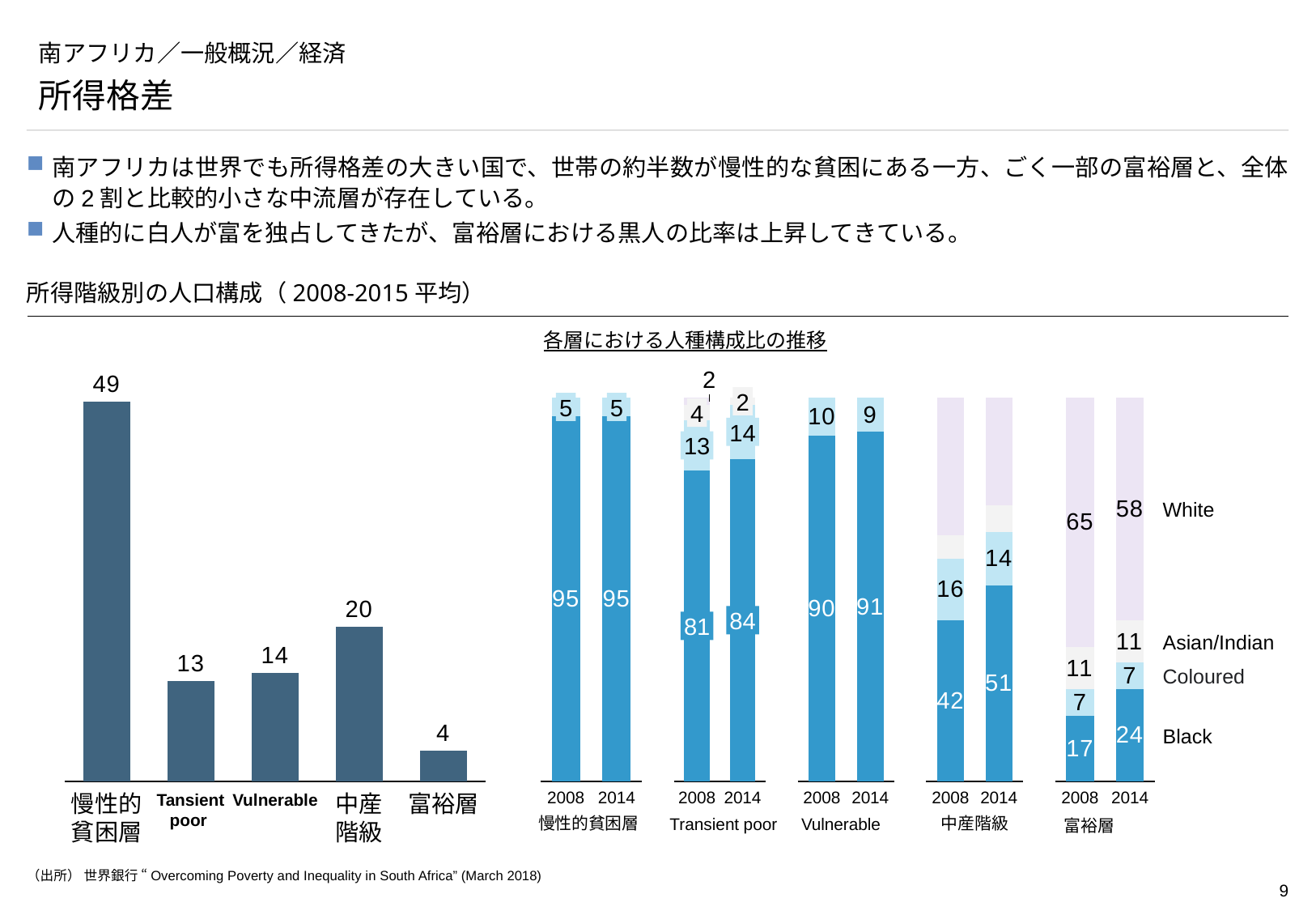
In the right chart (各層における人種構成比の推移), what is the White share of the 富裕層 in 2008? 65 In the right chart (各層における人種構成比の推移), is the Black share of Vulnerable larger in 2008 or 2014? 2014 In the right chart (各層における人種構成比の推移), what is the Black share of the 中産階級 in 2014? 51 In the right chart (各層における人種構成比の推移), what is the Black share of the 富裕層 in 2014? 24 In the left chart (所得階級別の人口構成), which category has the highest value? 慢性的貧困層 In the left chart (所得階級別の人口構成), what is the difference between the values for Vulnerable and Tansient poor? 1 In the left chart (所得階級別の人口構成), which category has the lowest value? 富裕層 What kind of chart is the left chart (所得階級別の人口構成)? bar chart In the left chart (所得階級別の人口構成), what is the value for 慢性的貧困層? 49 In the left chart (所得階級別の人口構成), how many categories are shown? 5 In the right chart (各層における人種構成比の推移), how many racial groups does the legend list? 4 In the left chart (所得階級別の人口構成), what is the value for 中産階級? 20